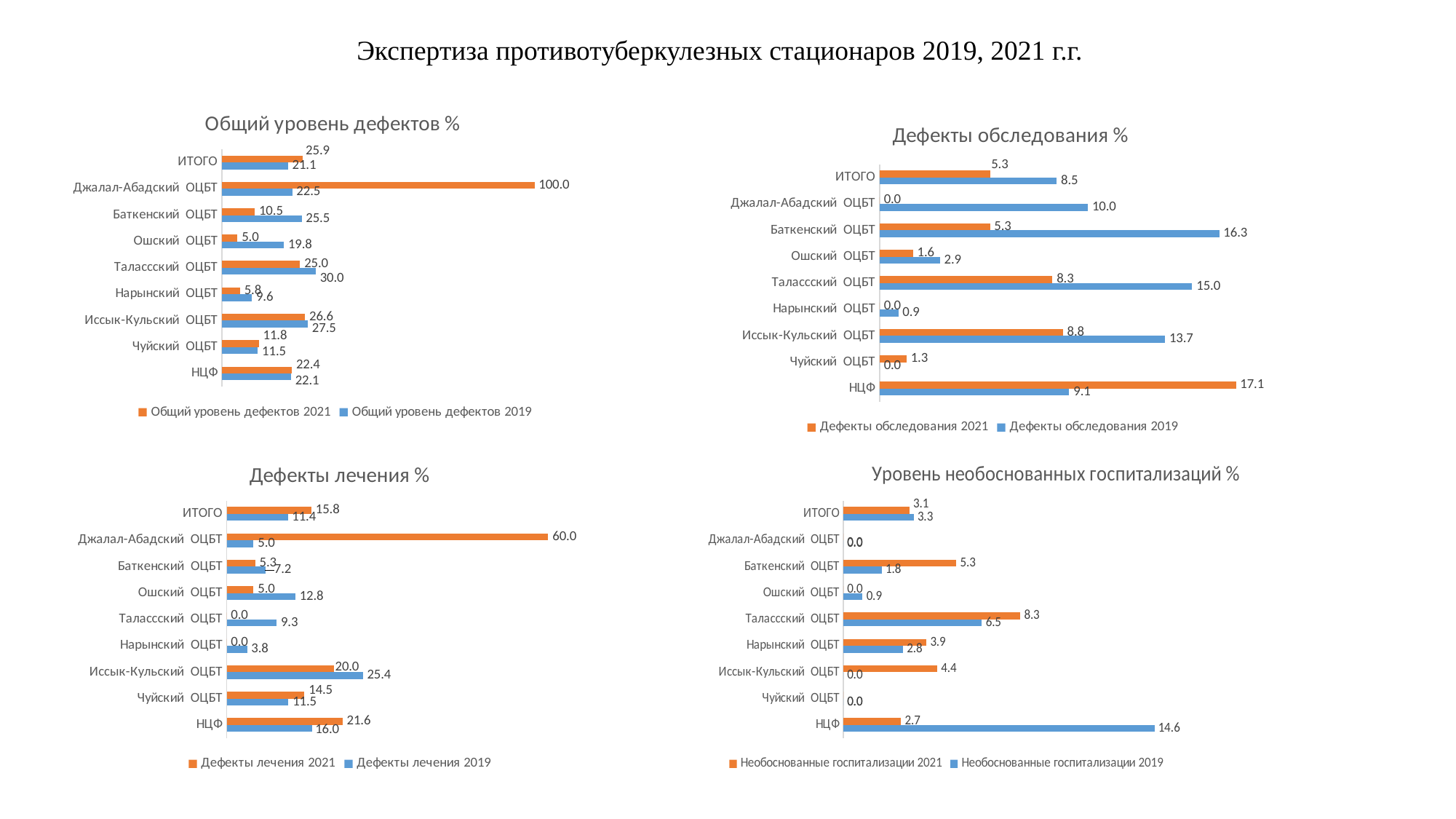
In the chart 'Уровень необоснованных госпитализаций %', what is the difference between the 2021 and 2019 values for Таласский ОЦБТ? 1.8 In the chart 'Общий уровень дефектов %', what is the value for Джалал-Абадский ОЦБТ in the series 'Общий уровень дефектов 2021'? 100.0 In the chart 'Дефекты лечения %', which category has the lowest value in the series 'Дефекты лечения 2019'? Нарынский ОЦБТ In the chart 'Уровень необоснованных госпитализаций %', what is the value for НЦФ in the series 'Необоснованные госпитализации 2019'? 14.6 How many categories are shown in the chart 'Дефекты лечения %'? 9 In the chart 'Общий уровень дефектов %', which category has the highest value in the series 'Общий уровень дефектов 2019'? Талассский ОЦБТ In the chart 'Дефекты обследования %', which category has the highest value in the series 'Дефекты обследования 2021'? НЦФ In the chart 'Дефекты обследования %', which is larger for Баткенский ОЦБТ: the 2021 value or the 2019 value? 2019 value In the chart 'Общий уровень дефектов %', what is the difference between the 2021 and 2019 values for ИТОГО? 4.8 In the chart 'Дефекты лечения %', what is the value for Иссык-Кульский ОЦБТ in the series 'Дефекты лечения 2019'? 25.4 What kind of chart is 'Общий уровень дефектов %'? Bar chart In the chart 'Дефекты обследования %', what is the value for НЦФ in the series 'Дефекты обследования 2019'? 9.1